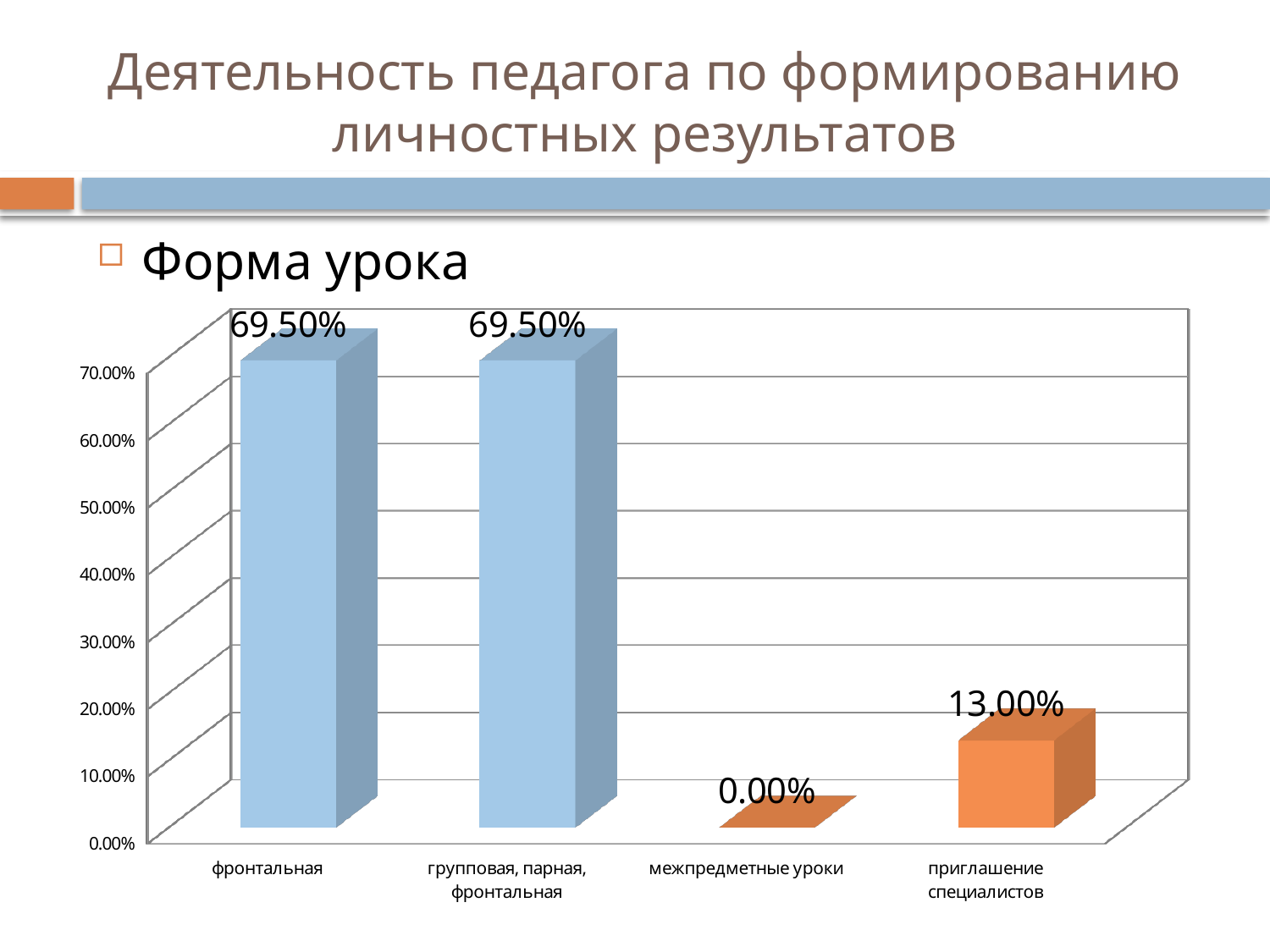
What is the value for межпредметные уроки? 0.00% What is the value for приглашение специалистов? 13.00% Is the value for приглашение специалистов greater or less than 20.00%? less What is the value for групповая, парная, фронтальная? 69.50% What is the value for фронтальная? 69.50% What is the difference between the values for фронтальная and приглашение специалистов? 56.50% Which is larger, the value for приглашение специалистов or the value for межпредметные уроки? приглашение специалистов How many categories are shown on the x axis? 4 What kind of chart is shown on the slide? bar chart What is the heading shown above the chart? Форма урока Which category has the lowest value? межпредметные уроки What is the difference between the values for групповая, парная, фронтальная and межпредметные уроки? 69.50%